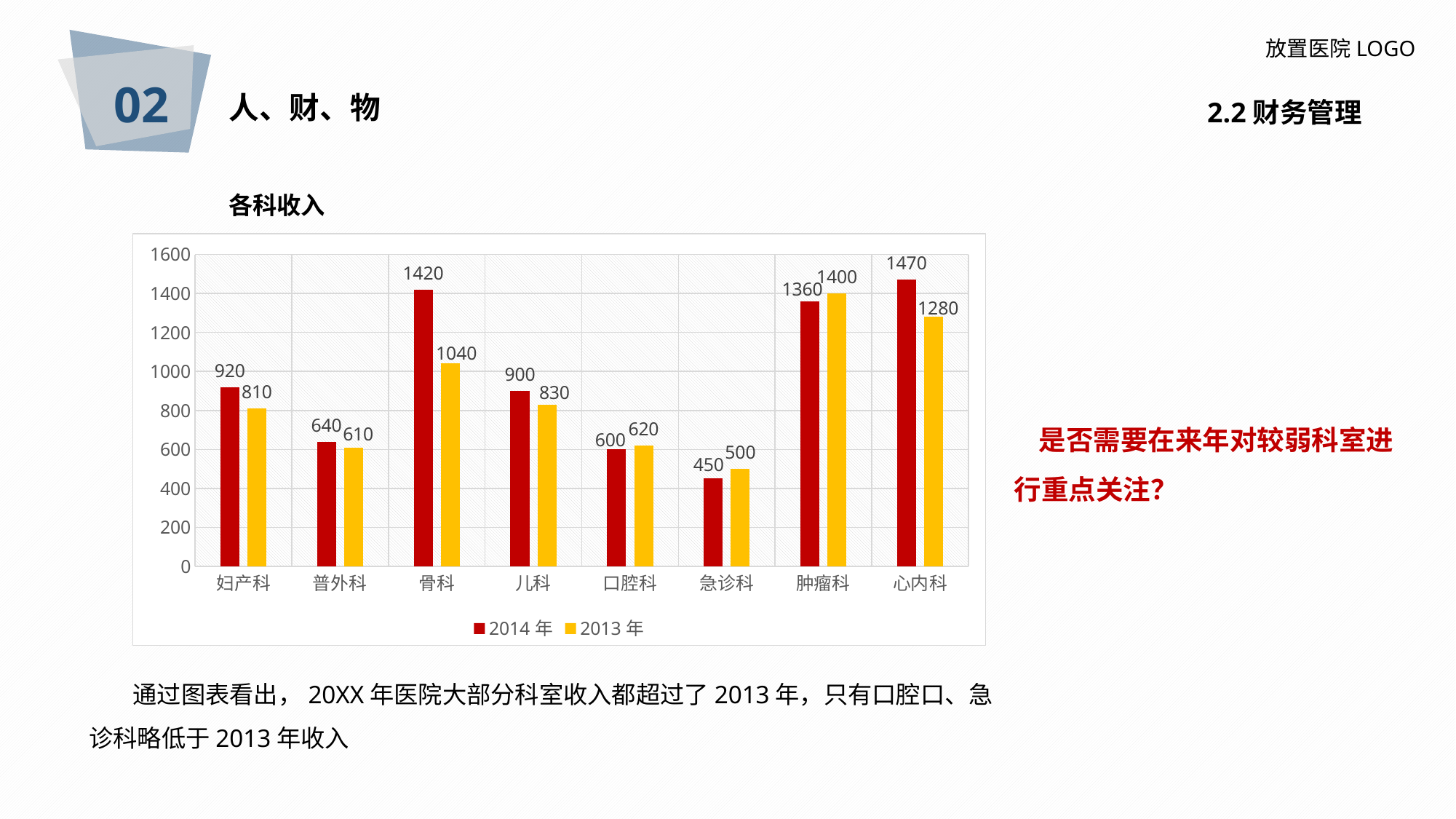
Which department has the lowest 2013 年 value? 急诊科 How many departments are shown on the x axis? 8 What kind of chart is shown? bar chart How many series does the legend list? 2 What is the 2014 年 value for 骨科? 1420 Is the 2014 年 value for 肿瘤科 greater or less than 1200? greater What is the difference between the 2014 年 and 2013 年 values for 骨科? 380 Which department has the highest 2014 年 value? 心内科 What is the 2013 年 value for 心内科? 1280 Which is larger for 口腔科, the 2014 年 value or the 2013 年 value? 2013 年 What is the title of the chart? 各科收入 What is the 2013 年 value for 急诊科? 500